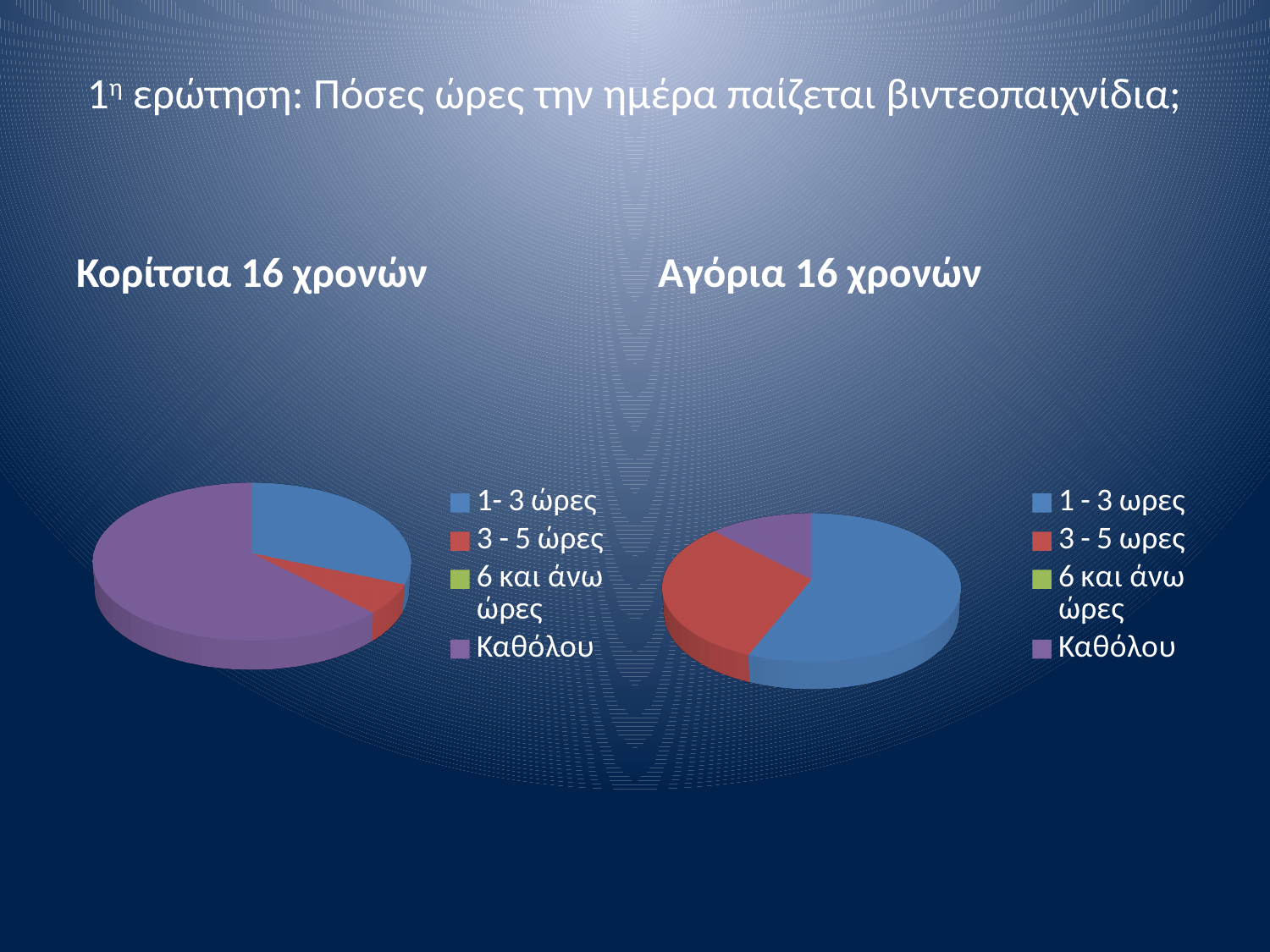
What kind of chart is used for the 'Κορίτσια 16 χρονών' chart? Pie chart In the 'Αγόρια 16 χρονών' chart, what colour represents the 'Καθόλου' category? Purple In the 'Αγόρια 16 χρονών' chart, which slice is larger: '3 - 5 ωρες' or 'Καθόλου'? 3 - 5 ωρες How many categories does the legend of the 'Αγόρια 16 χρονών' chart list? 4 What is the title of the pie chart on the left of the slide? Κορίτσια 16 χρονών In the 'Αγόρια 16 χρονών' chart, which category has the largest slice? 1 - 3 ωρες In the 'Αγόρια 16 χρονών' chart, which slice is larger: '1 - 3 ωρες' or '3 - 5 ωρες'? 1 - 3 ωρες In the 'Κορίτσια 16 χρονών' chart, which slice is larger: '1- 3 ώρες' or '3 - 5 ώρες'? 1- 3 ώρες What kind of chart is used for the 'Αγόρια 16 χρονών' chart? Pie chart In the 'Κορίτσια 16 χρονών' chart, which category has the largest slice? Καθόλου How many categories does the legend of the 'Κορίτσια 16 χρονών' chart list? 4